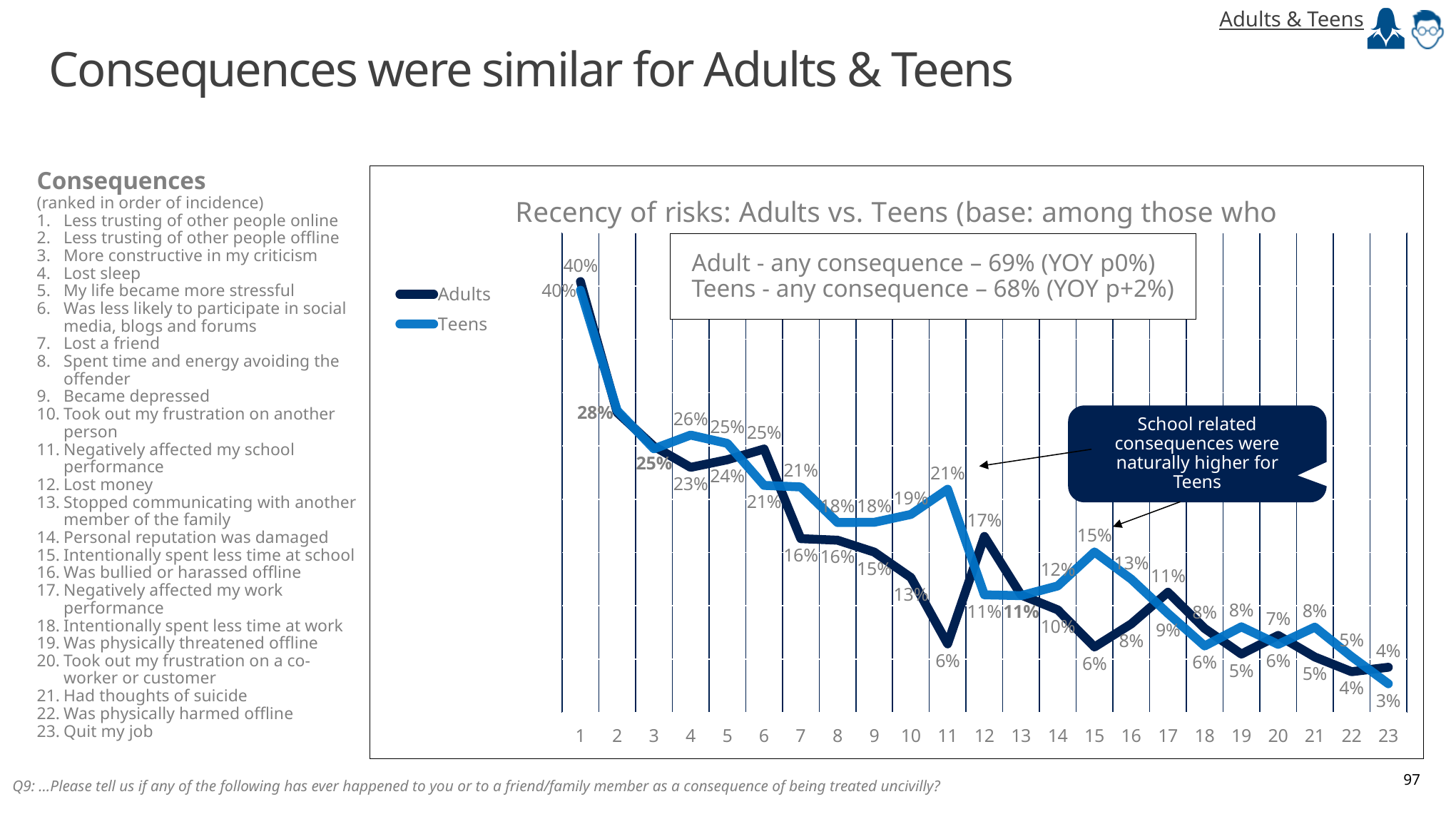
What is the value for Adults at category 23? 4% What kind of chart is shown on the slide? line chart What is the value for Adults at category 1? 40% What is the difference between the Teens and Adults values at category 11? 15 percentage points At which category is the Adults series highest? 1 Do the values generally rise or fall from category 1 to category 23? fall How many series does the legend list? 2 What is the value for Teens at category 15? 15% What is the value for Teens at category 11? 21% How many categories are plotted along the x axis? 23 What is the value for Adults at category 11? 6% At category 15, which series has the larger value, Adults or Teens? Teens